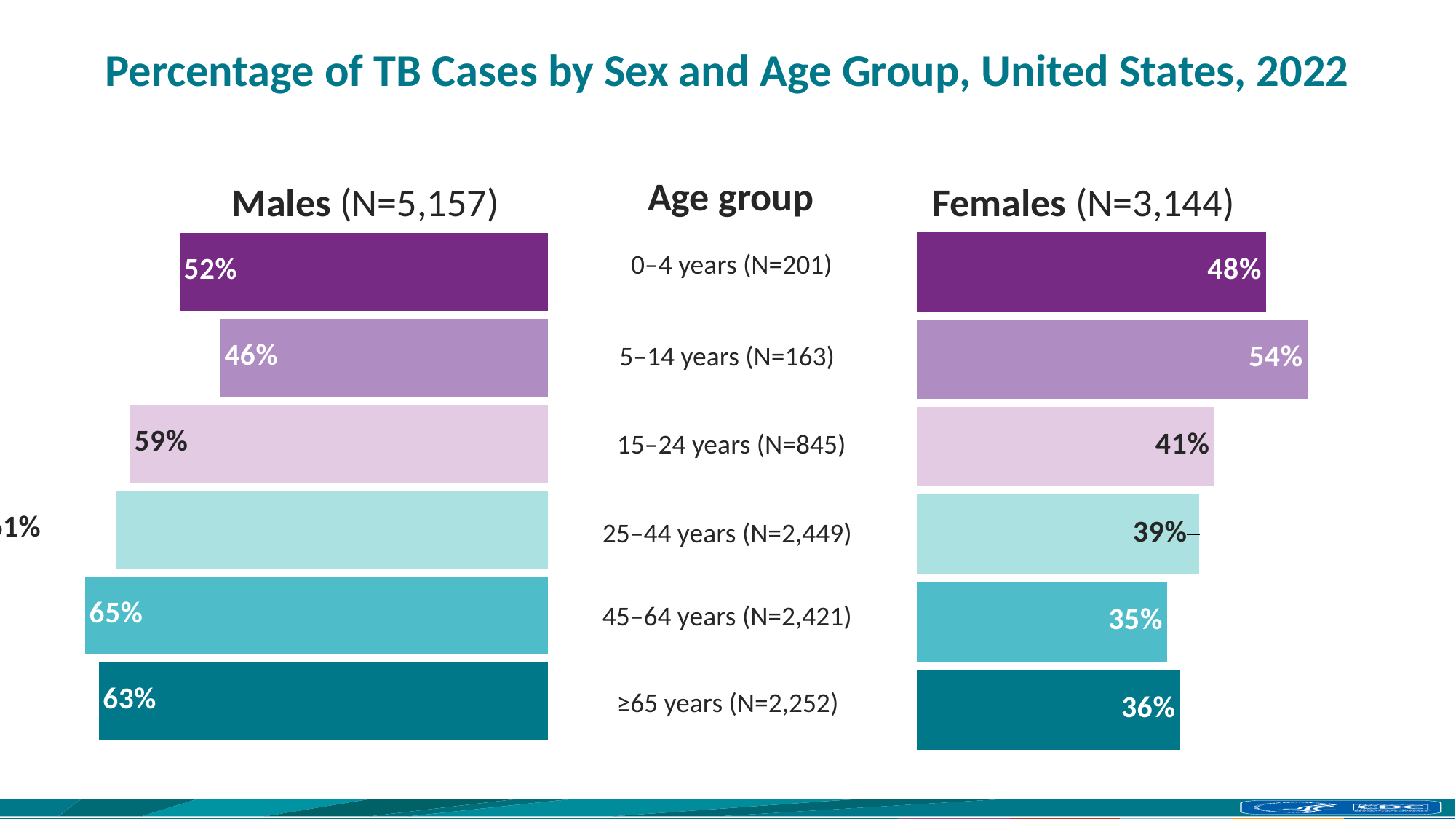
How many age groups are shown in the chart? 6 What percentage of TB cases among 45–64 years were females? 35% Is the female percentage higher for 0–4 years or for 25–44 years? 0–4 years Which age group has the lowest female percentage of TB cases? 45–64 years What is the difference between the male and female percentages for the 15–24 years age group? 18% What is the total number of male TB cases (N) shown in the chart heading? 5,157 Which age group has the highest male percentage of TB cases? 45–64 years What percentage of TB cases among ≥65 years were males? 63% What type of chart is shown on the slide? Bar chart What percentage of TB cases among 5–14 years were females? 54% Which age group has the highest female percentage of TB cases? 5–14 years What percentage of TB cases among 0–4 years were males? 52%